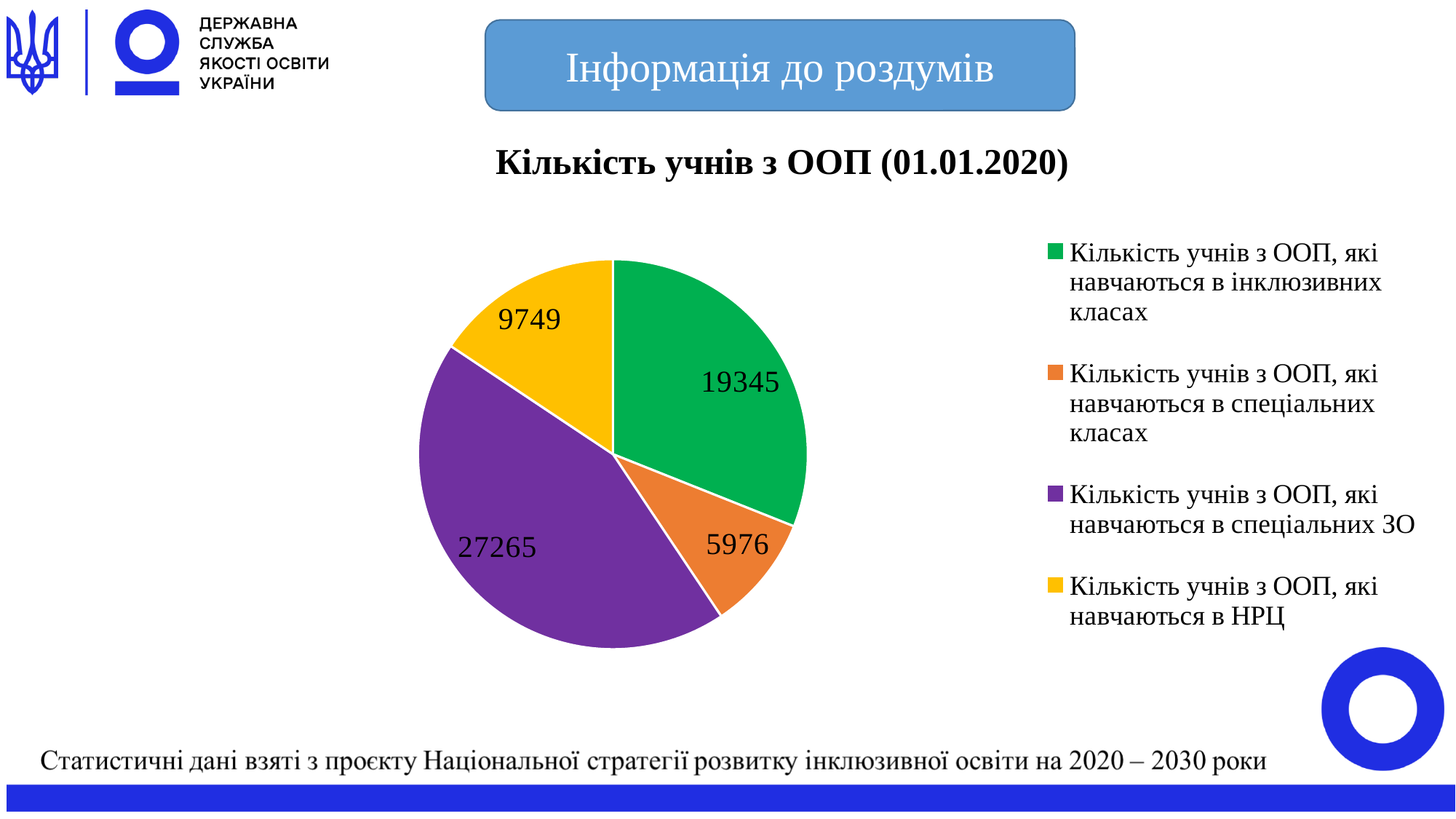
Which category has the largest slice of the pie? Кількість учнів з ООП, які навчаються в спеціальних ЗО What is the value for students with ООП studying in special ЗО (спеціальних ЗО)? 27265 What is the value for students with ООП studying in НРЦ? 9749 How many entries does the legend list? 4 What is the difference between the number of students in special ЗО and the number in inclusive classes? 7920 What is the value for students with ООП studying in special classes (спеціальних класах)? 5976 What is the value for students with ООП studying in inclusive classes (інклюзивних класах)? 19345 Which category has the smallest slice of the pie? Кількість учнів з ООП, які навчаються в спеціальних класах What type of chart is shown on the slide? pie chart How many slices does the pie chart have? 4 Which is larger: the number of students in НРЦ or the number in special classes? НРЦ (9749) What is the title of the chart? Кількість учнів з ООП (01.01.2020)